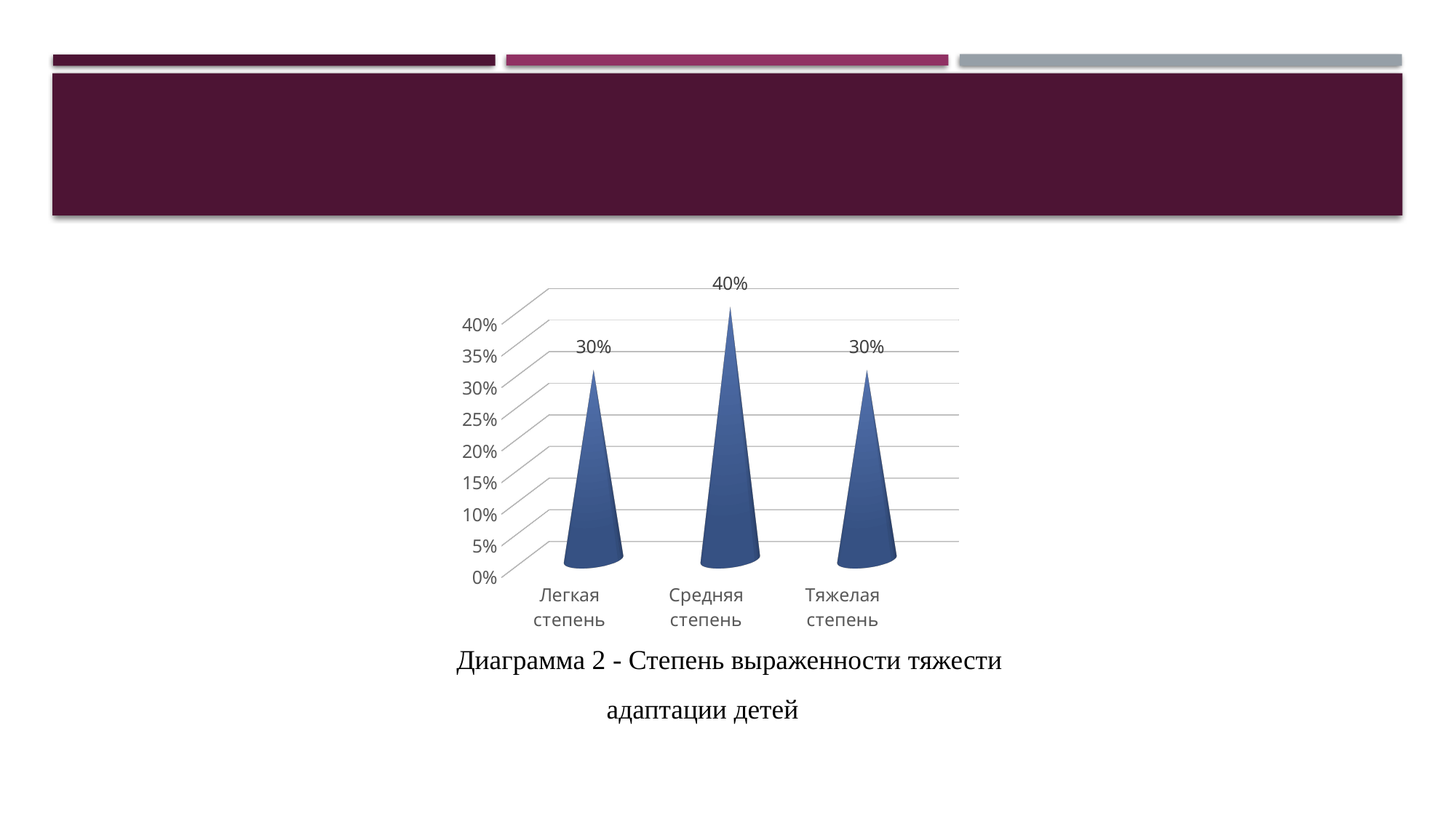
What is the difference between the values for Средняя степень and Легкая степень? 10% What is the value for Легкая степень? 30% How many categories are shown on the x axis? 3 What is the value for Средняя степень? 40% Is the value for Легкая степень greater or less than 35%? less What is the caption printed below the chart? Диаграмма 2 - Степень выраженности тяжести адаптации детей What is the highest value shown on the vertical axis? 40% What kind of chart is shown on the slide? bar chart Is the value for Средняя степень greater or less than 35%? greater Which category has the highest value? Средняя степень What is the value for Тяжелая степень? 30% Which is larger, the value for Средняя степень or the value for Тяжелая степень? Средняя степень